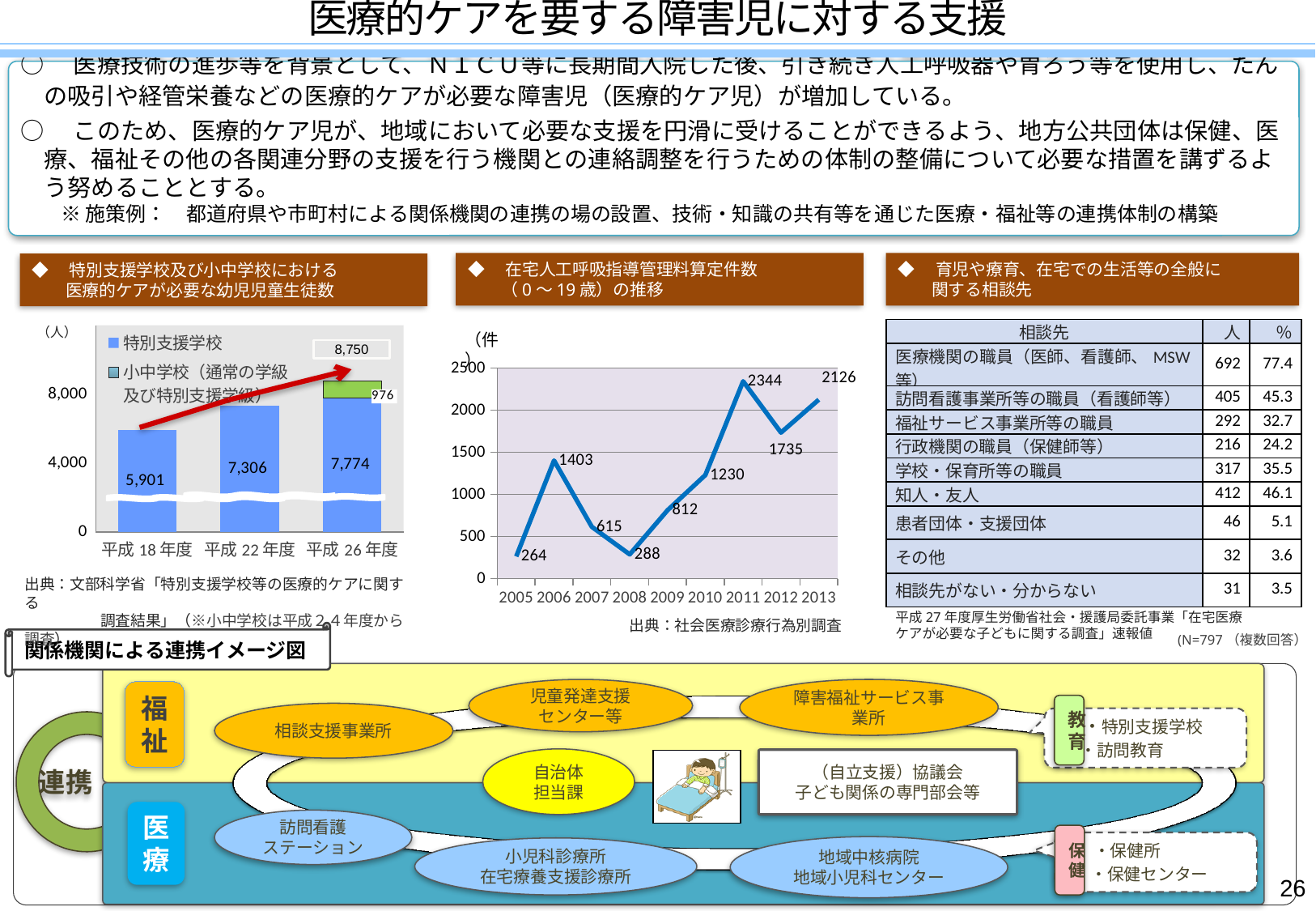
In the left bar chart, what is the value for 小中学校 in 平成26年度? 976 In the middle line chart, which year has the lowest value? 2005 In the left bar chart, do the 特別支援学校 values rise or fall from 平成18年度 to 平成26年度? rise What kind of chart is the left chart showing 特別支援学校 and 小中学校? bar chart In the left bar chart, what is the difference between the 特別支援学校 values for 平成26年度 and 平成18年度? 1,873 In the left bar chart, how many year categories are shown on the x axis? 3 In the left bar chart (特別支援学校及び小中学校における医療的ケアが必要な幼児児童生徒数), what is the value for 特別支援学校 in 平成22年度? 7,306 In the left bar chart, what is the total of the stacked bar for 平成26年度? 8,750 In the middle line chart (在宅人工呼吸指導管理料算定件数の推移), which year has the highest value? 2011 In the left bar chart, how many series does the legend list? 2 In the middle line chart, what is the difference between the values for 2011 and 2012? 609 In the middle line chart, what is the value for 2009? 812